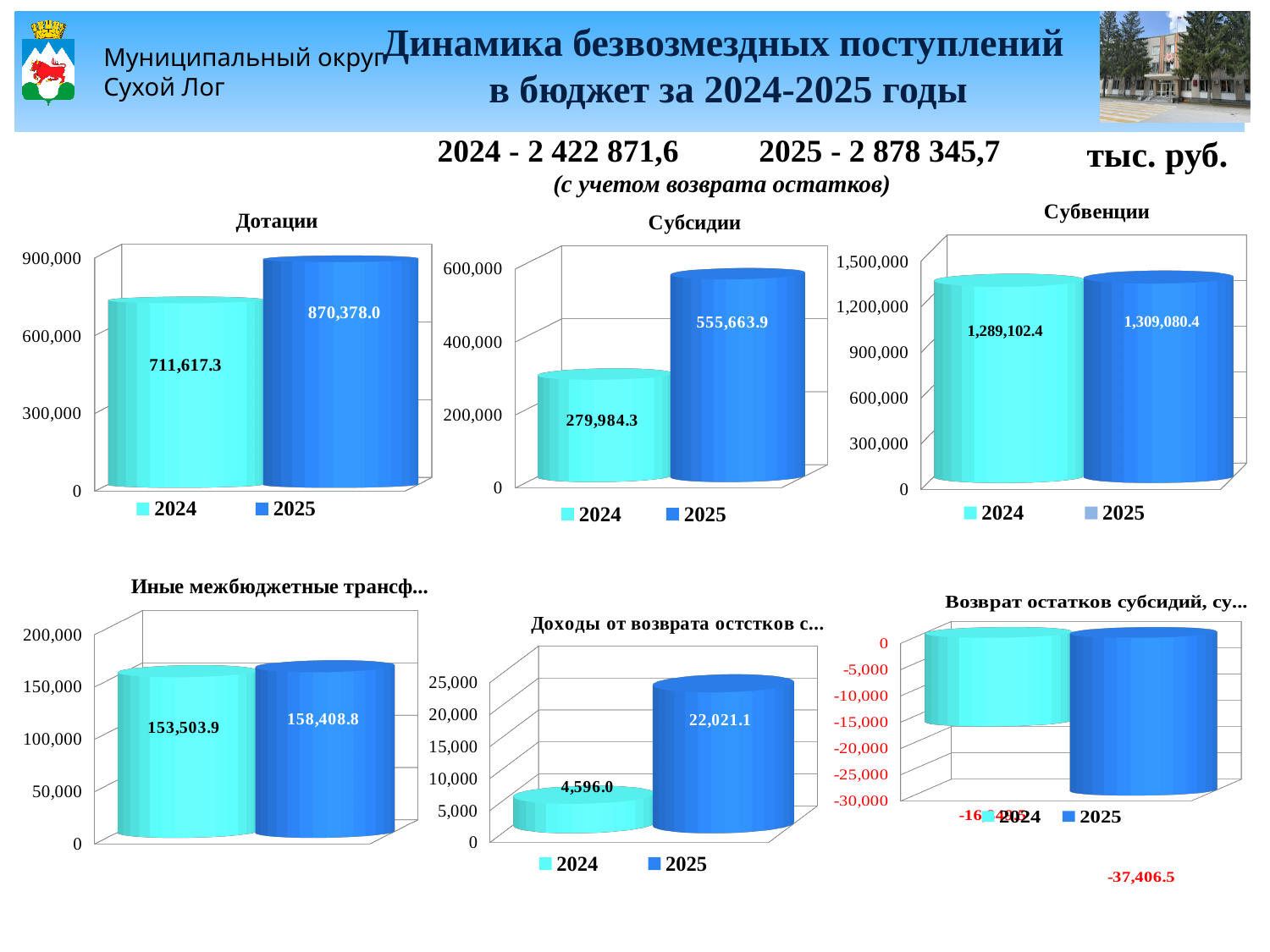
In the 'Доходы от возврата остстков с...' chart, what is the difference between the 2025 and 2024 values? 17,425.1 In the 'Возврат остатков субсидий, су...' chart, what is the value for 2025? -37,406.5 In the 'Субвенции' chart, what is the value for 2025? 1,309,080.4 In the 'Дотации' chart, what is the value for 2025? 870,378.0 In the 'Иные межбюджетные трансф...' chart, what is the value for 2024? 153,503.9 How many series does the legend of the 'Дотации' chart list? 2 In the 'Дотации' chart, what is the value for 2024? 711,617.3 In the 'Доходы от возврата остстков с...' chart, what is the value for 2025? 22,021.1 In the 'Субвенции' chart, which year has the larger value, 2024 or 2025? 2025 What kind of chart is the 'Субсидии' chart? Bar chart In the 'Субсидии' chart, what is the difference between the 2025 and 2024 values? 275,679.6 In the 'Субсидии' chart, what is the value for 2024? 279,984.3